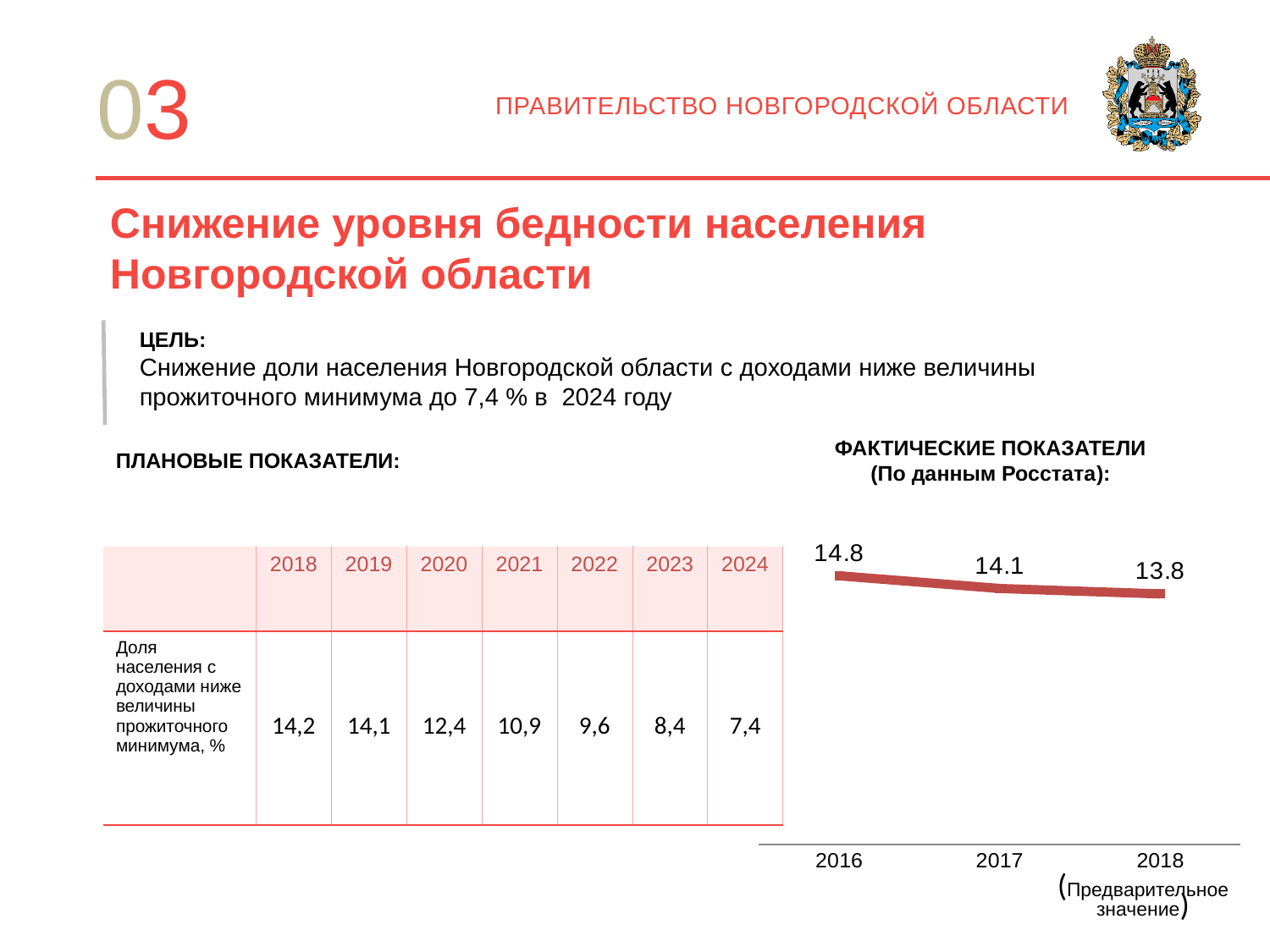
In the line chart of actual indicators, what is the value for 2017? 14.1 What type of chart is shown under "ФАКТИЧЕСКИЕ ПОКАЗАТЕЛИ (По данным Росстата)"? line chart In the line chart of actual indicators, what is the difference between the 2016 and 2018 values? 1.0 In the line chart of actual indicators, which is larger: the value for 2017 or the value for 2018? 2017 In the line chart of actual indicators, what is the value for 2018? 13.8 In the line chart of actual indicators, which year has the lowest value? 2018 Do the values in the line chart of actual indicators rise or fall from 2016 to 2018? fall In the line chart of actual indicators, which year has the highest value? 2016 How many data points are plotted in the line chart of actual indicators? 3 In the line chart of actual indicators, what is the value for 2016? 14.8 Which year in the line chart of actual indicators is marked as a preliminary value (Предварительное значение)? 2018 In the line chart of actual indicators, what is the difference between the 2016 and 2017 values? 0.7